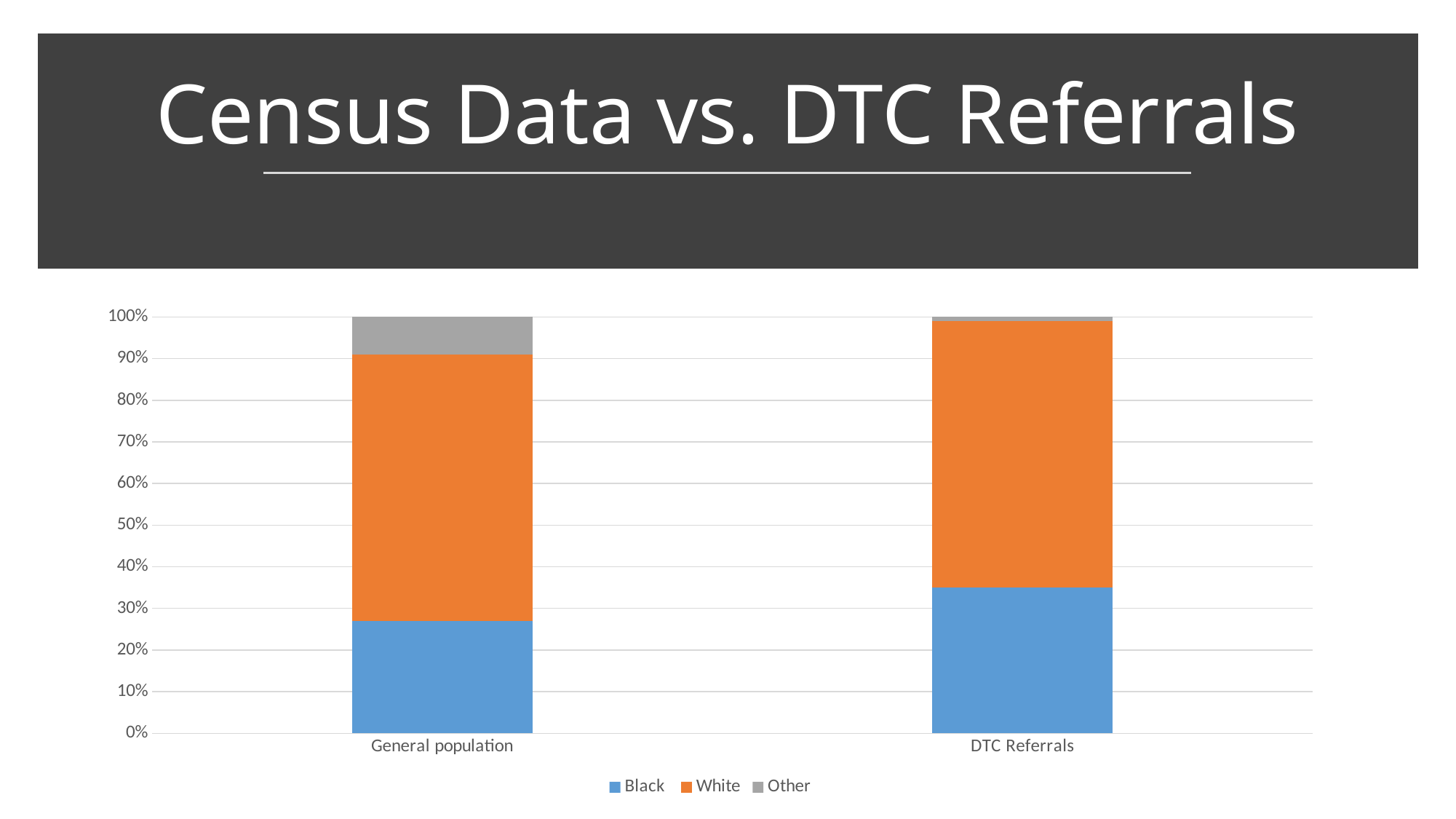
How many categories are shown on the x axis? 2 Is the Black share for General population greater or less than 30%? less Which series takes up the largest portion of the General population bar? White What kind of chart is shown on the slide? Stacked bar chart Which category has the larger Black share, General population or DTC Referrals? DTC Referrals Which category has the larger Other share, General population or DTC Referrals? General population What are the series listed in the legend? Black, White, Other What is the total height of the stacked bar for General population? 100% Is the Black share for DTC Referrals greater or less than 30%? greater Is the Other share for DTC Referrals greater or less than 10%? less What is the title of the slide containing the chart? Census Data vs. DTC Referrals How many series does the legend list? 3